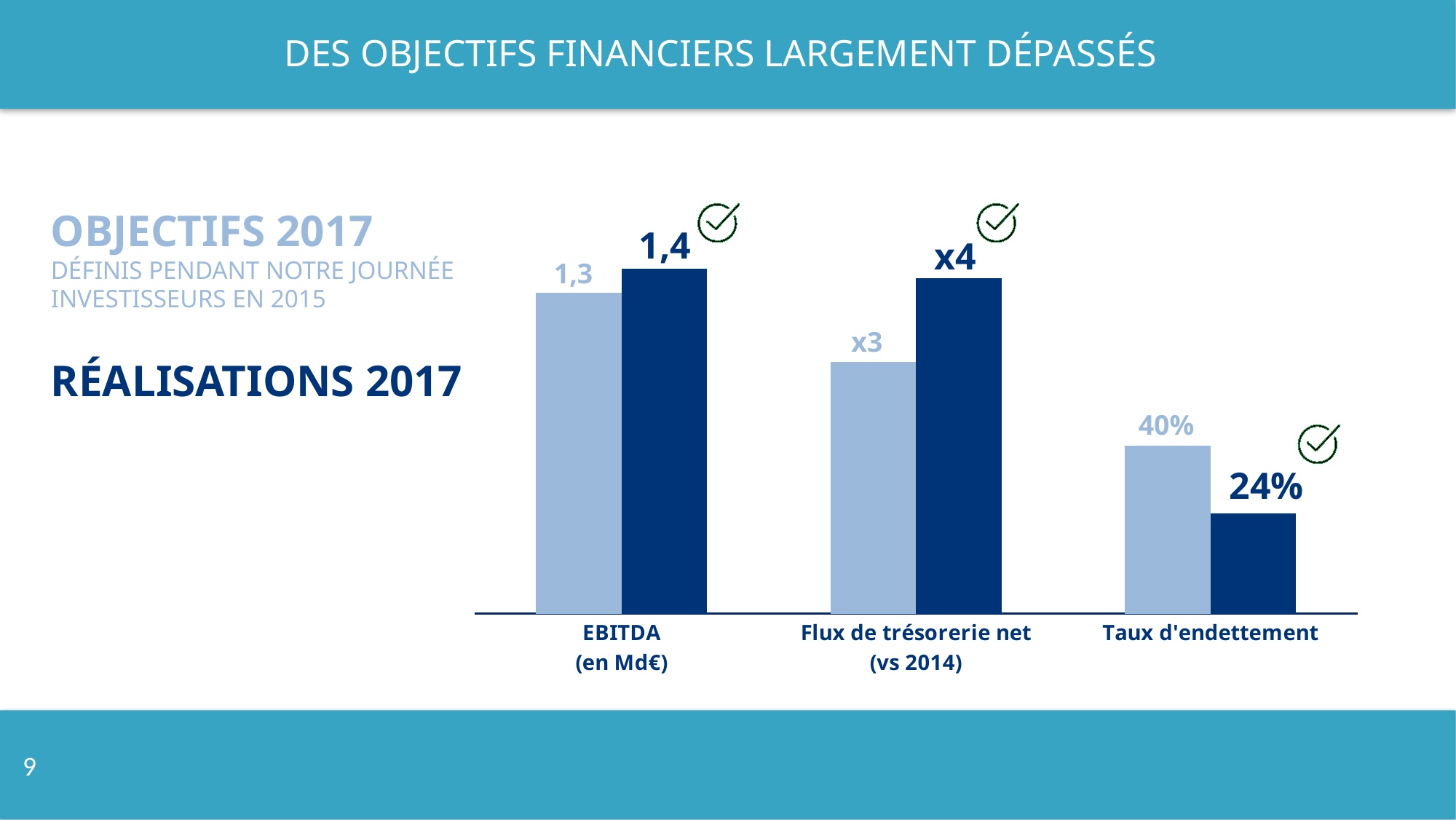
What kind of chart is shown on the slide? Bar chart How many categories are shown on the x axis of the chart? 3 What is the Réalisations 2017 value for Flux de trésorerie net (vs 2014)? x4 What is the Objectifs 2017 value for Taux d'endettement? 40% What is the difference between the Objectifs 2017 and Réalisations 2017 values for Taux d'endettement? 16 percentage points For Taux d'endettement, which is larger: the Objectifs 2017 value or the Réalisations 2017 value? Objectifs 2017 What is the Objectifs 2017 value for EBITDA (en Md€)? 1,3 For EBITDA (en Md€), which is larger: the Objectifs 2017 value or the Réalisations 2017 value? Réalisations 2017 What is the Objectifs 2017 value for Flux de trésorerie net (vs 2014)? x3 What is the Réalisations 2017 value for EBITDA (en Md€)? 1,4 What is the Réalisations 2017 value for Taux d'endettement? 24% How many series does the chart show? 2